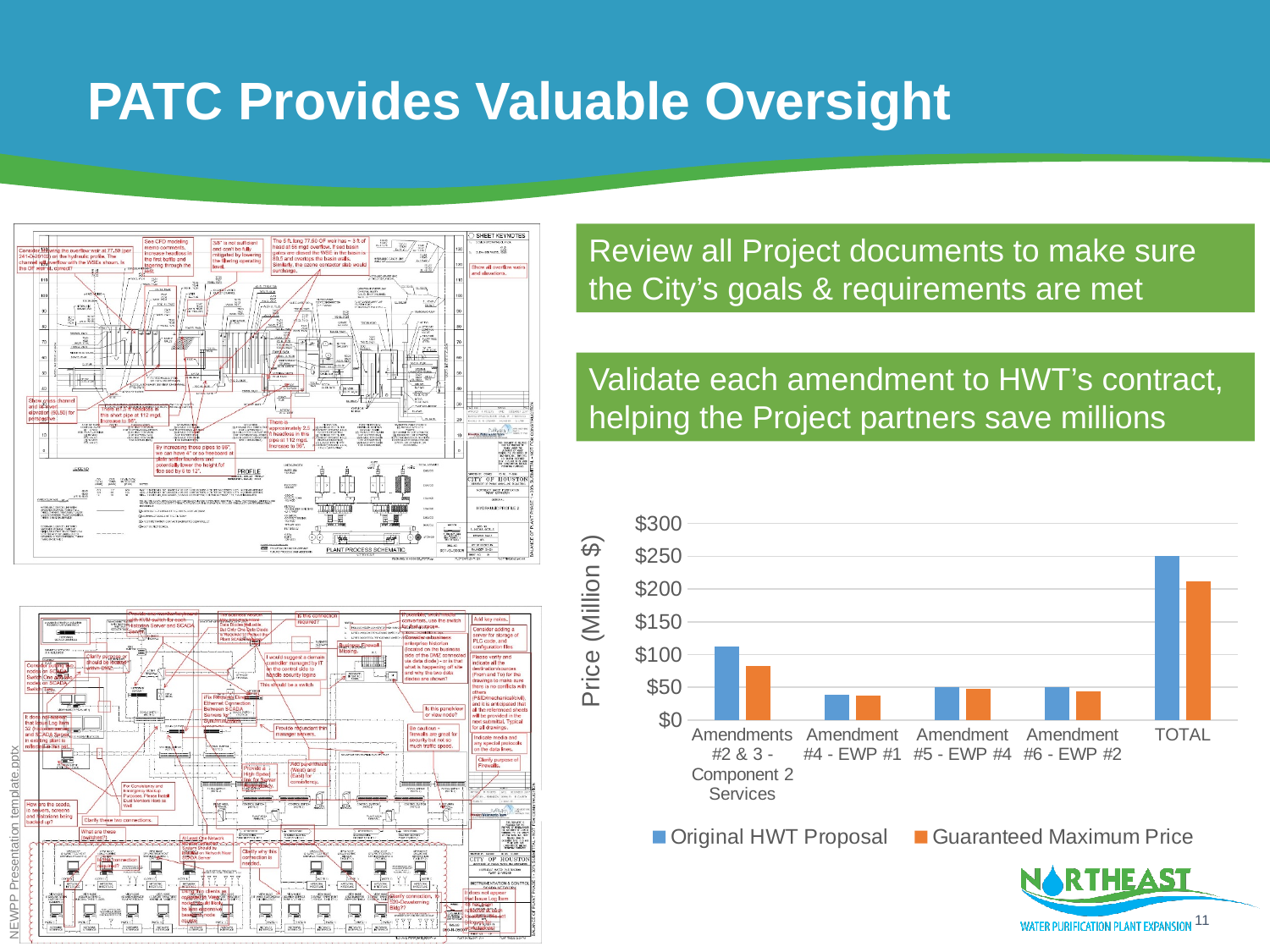
What is the title of the chart's vertical axis? Price (Million $) Is the Original HWT Proposal value for Amendments #2 & 3 - Component 2 Services greater or less than $100? greater What kind of chart is shown on the slide? bar chart Is the Original HWT Proposal value for Amendment #4 - EWP #1 greater or less than $50? less For TOTAL, which is larger: the Original HWT Proposal or the Guaranteed Maximum Price? Original HWT Proposal Which category has the lowest Guaranteed Maximum Price value? Amendment #4 - EWP #1 How many series does the chart's legend list? 2 Is the Original HWT Proposal value for TOTAL greater or less than $200? greater How many categories are shown along the x axis of the chart? 5 Which category has the highest Original HWT Proposal value? TOTAL